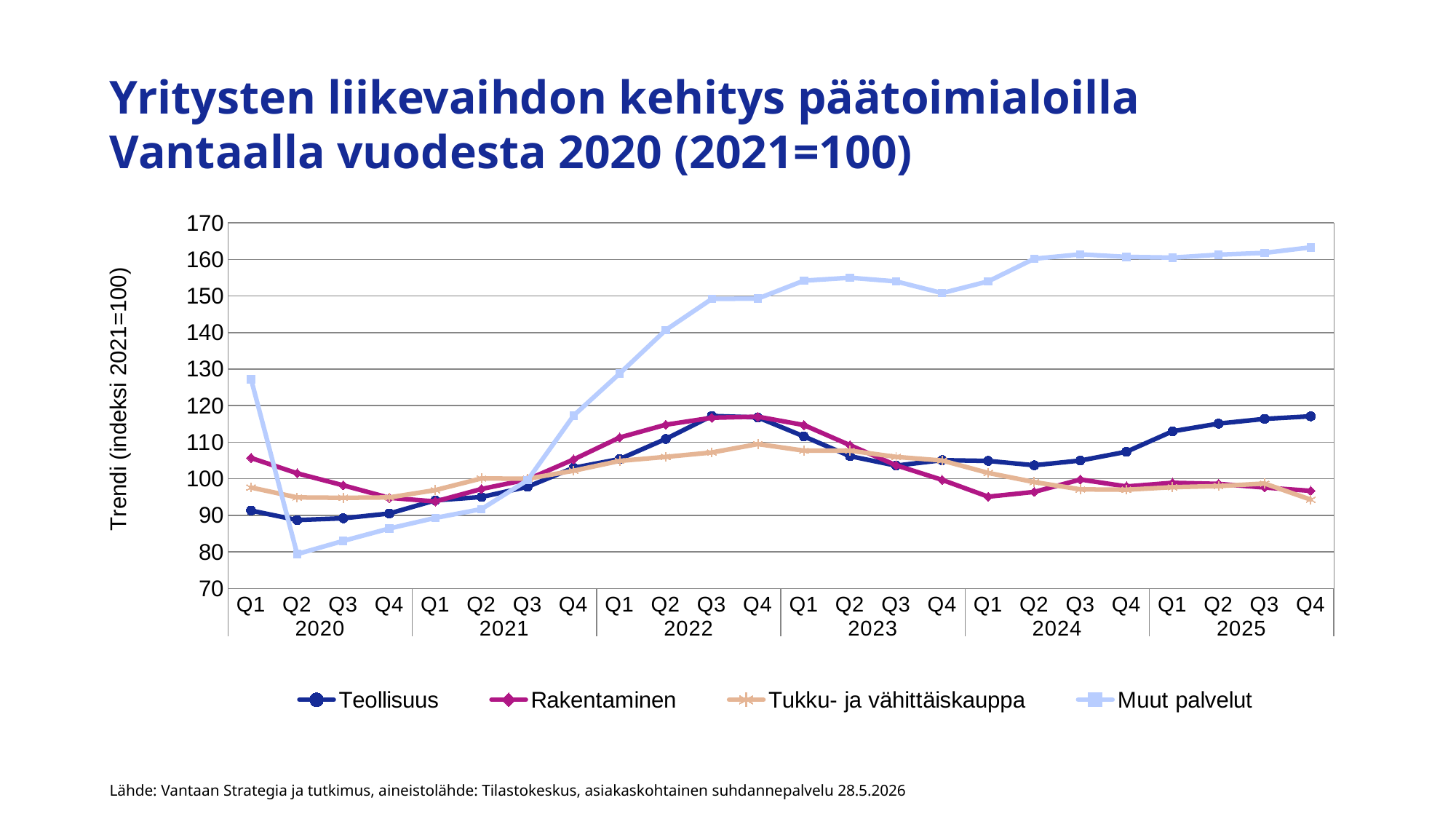
Is the value for Rakentaminen in Q1 2024 greater or less than 100? less In Q4 2025, which is larger: Teollisuus or Rakentaminen? Teollisuus In Q1 2020, which is larger: Muut palvelut or Teollisuus? Muut palvelut What kind of chart is shown on the slide? line chart How many series does the legend list? 4 Is the value for Tukku- ja vähittäiskauppa in Q4 2022 greater or less than 100? greater Is the value for Muut palvelut in Q4 2025 greater or less than 160? greater How many quarterly data points does each series have on the x axis? 24 Which series has the lowest value in Q2 2020? Muut palvelut Does the Muut palvelut series rise or fall from Q2 2020 to Q4 2025? rise